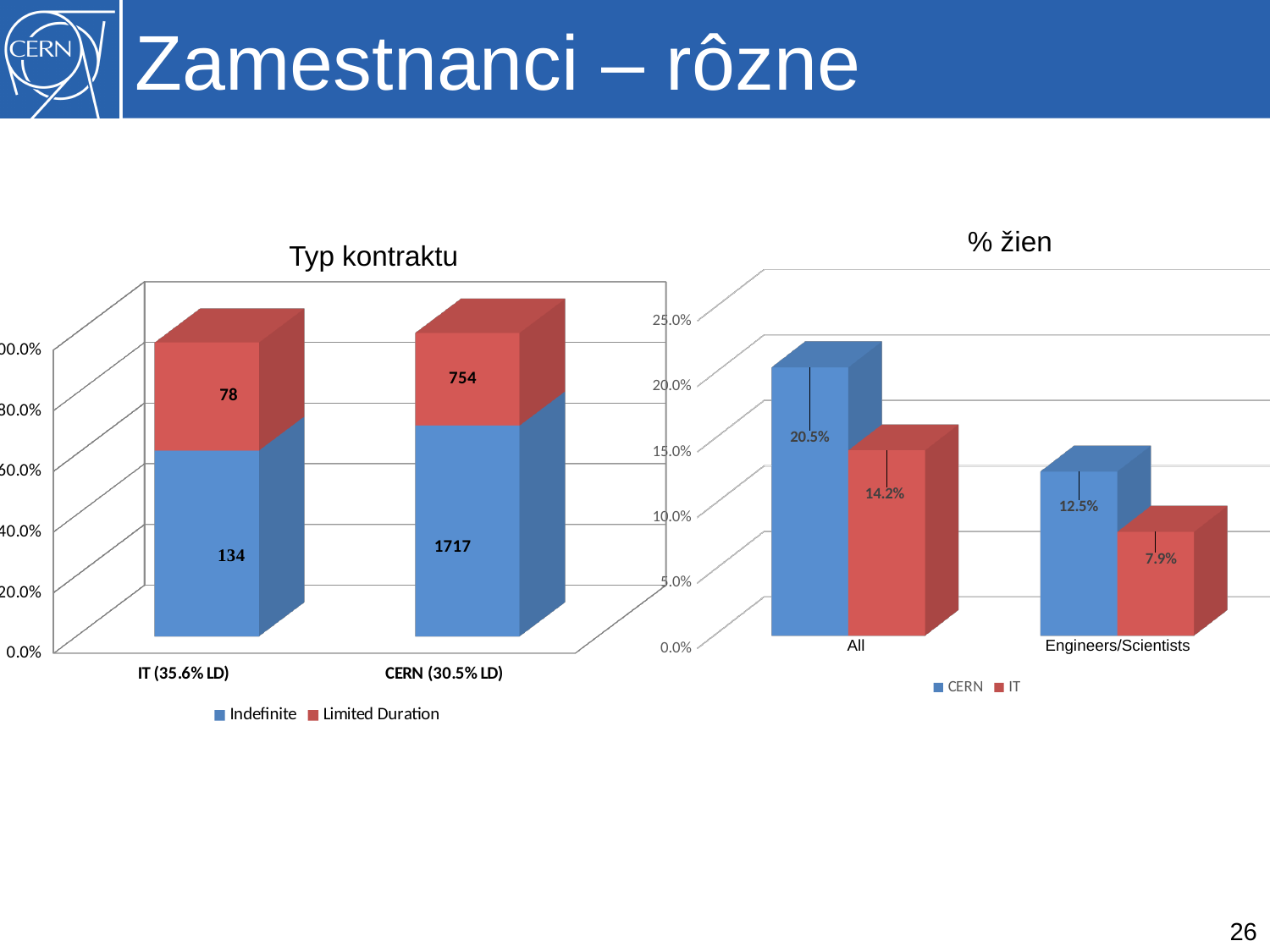
In the 'Typ kontraktu' chart, how many series does the legend list? 2 In the '% žien' chart, is the CERN value for All greater or less than 20.0%? greater In the 'Typ kontraktu' chart, what kind of chart is shown? Stacked bar chart In the 'Typ kontraktu' chart, what is the Indefinite value for IT (35.6% LD)? 134 In the '% žien' chart, what is the CERN value for All? 20.5% In the '% žien' chart, what is the IT value for Engineers/Scientists? 7.9% In the 'Typ kontraktu' chart, what is the Limited Duration value for CERN (30.5% LD)? 754 In the '% žien' chart, which bar has the lowest value? IT, Engineers/Scientists (7.9%) In the '% žien' chart, how many categories are shown on the x axis? 2 In the 'Typ kontraktu' chart, what is the total of the two labelled values for the CERN (30.5% LD) bar? 2471 In the '% žien' chart, what is the difference between the CERN and IT values for All? 6.3% In the 'Typ kontraktu' chart, what is the total of the two labelled values for the IT (35.6% LD) bar? 212